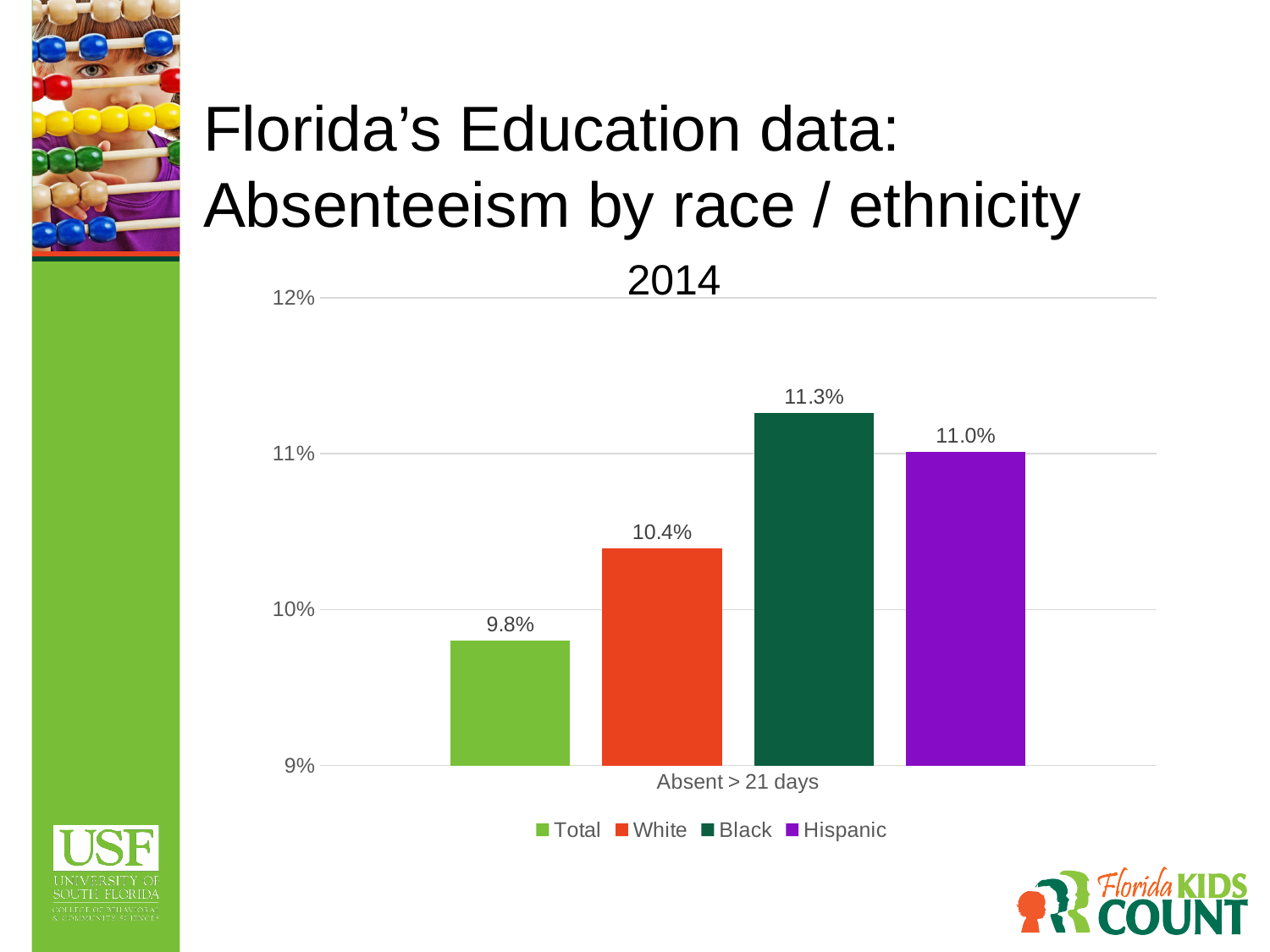
Is the value for Total greater or less than 10%? less What is the value shown for Hispanic students? 11.0% How many series does the legend list? 4 What is the difference between the Hispanic and Total values? 1.2% Which is larger, the value for White or the value for Hispanic? Hispanic What is the absenteeism value for White students? 10.4% Which series has the highest absenteeism value? Black What is the difference between the Black and White absenteeism values? 0.9% Which series has the lowest absenteeism value? Total What kind of chart is shown on the slide? bar chart What is the value shown for the Total series? 9.8% What is the absenteeism value for Black students in the chart? 11.3%